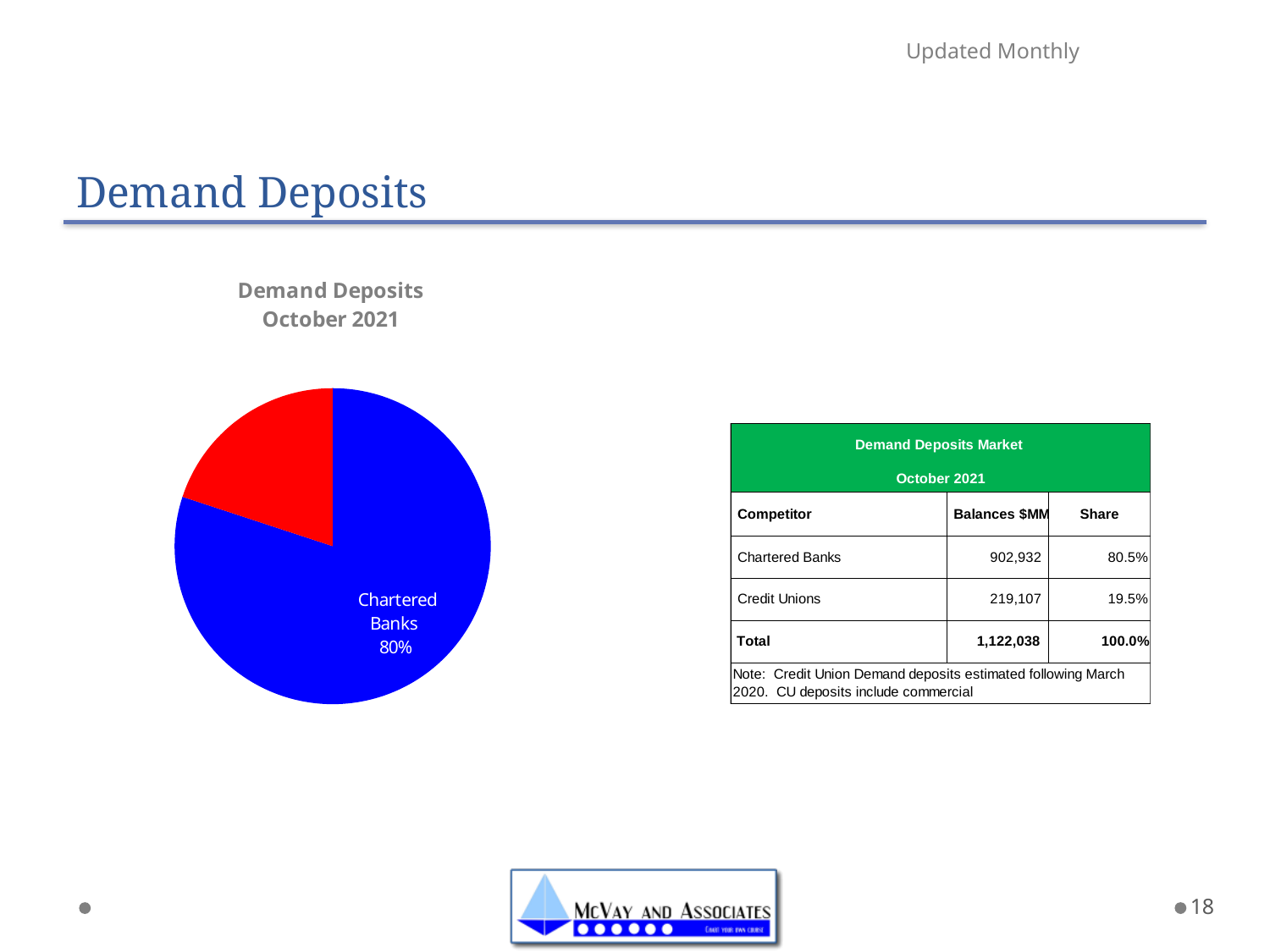
Is the red slice of the pie greater or less than 50% of the pie? less What colour is the Chartered Banks slice in the pie chart? blue Which is larger in the pie chart, the blue slice or the red slice? the blue slice Is the share for Chartered Banks greater or less than 50%? greater How many slices does the pie chart have? 2 What share of the pie does Chartered Banks hold? 80% What is the title of the pie chart? Demand Deposits October 2021 What kind of chart is shown on the slide? pie chart Which slice of the pie chart is the largest? Chartered Banks